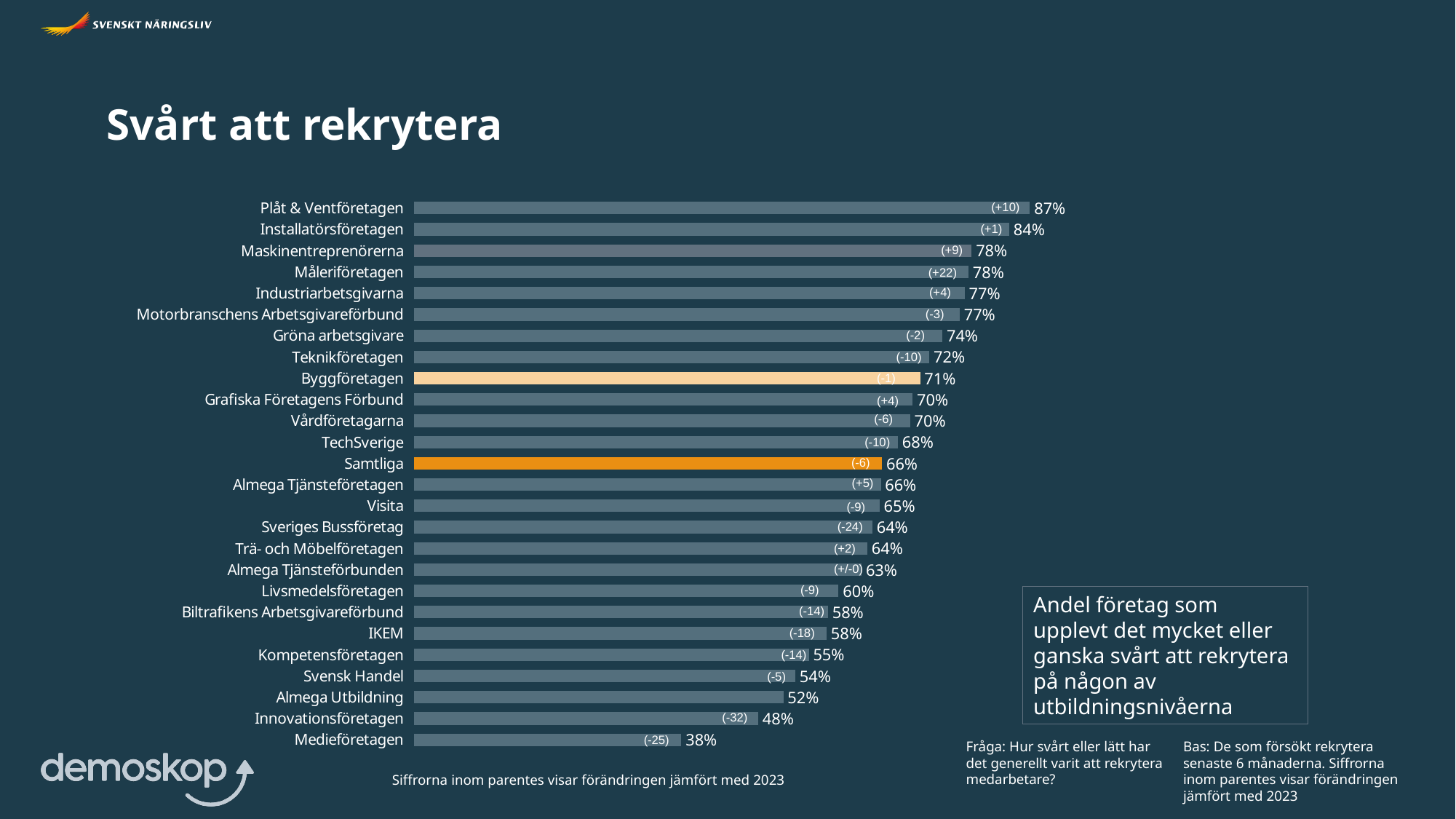
What is the value for Byggföretagen? 71% Which category has the highest value? Plåt & Ventföretagen What kind of chart is shown on the slide? Bar chart What change compared with 2023 is shown in parentheses for Sveriges Bussföretag? (-24) What is the title of the slide? Svårt att rekrytera What is the value for Samtliga? 66% What is the value for Medieföretagen? 38% Which category has the lowest value? Medieföretagen What is the value for Plåt & Ventföretagen? 87% Which is larger, the value for TechSverige or the value for Svensk Handel? TechSverige How many categories are shown in the chart? 26 What is the difference between the values for Installatörsföretagen and Innovationsföretagen? 36 percentage points